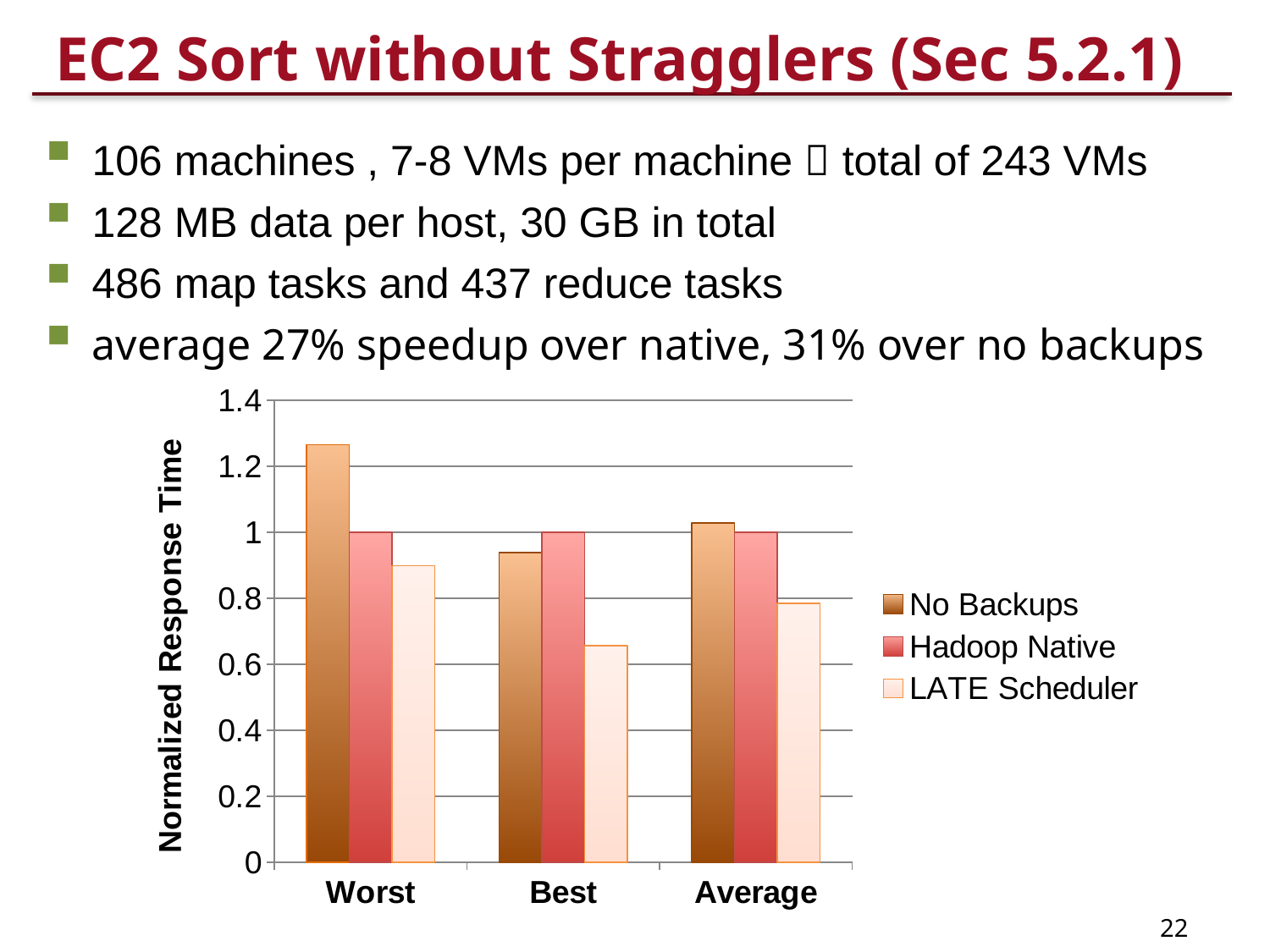
Which series has the highest value in the Worst category? No Backups In the Worst category, which is larger: No Backups or Hadoop Native? No Backups Is the value for No Backups in the Best category greater or less than 1? less What is the Normalized Response Time for Hadoop Native in the Best category? 1 How many categories are shown on the x axis? 3 What is the Normalized Response Time for Hadoop Native in the Worst category? 1 Is the value for LATE Scheduler in the Best category greater or less than 0.8? less How many series does the legend list? 3 What kind of chart is shown on the slide? bar chart Which series has the lowest value in the Best category? LATE Scheduler What is the label of the y axis? Normalized Response Time Is the value for No Backups in the Worst category greater or less than 1.2? greater